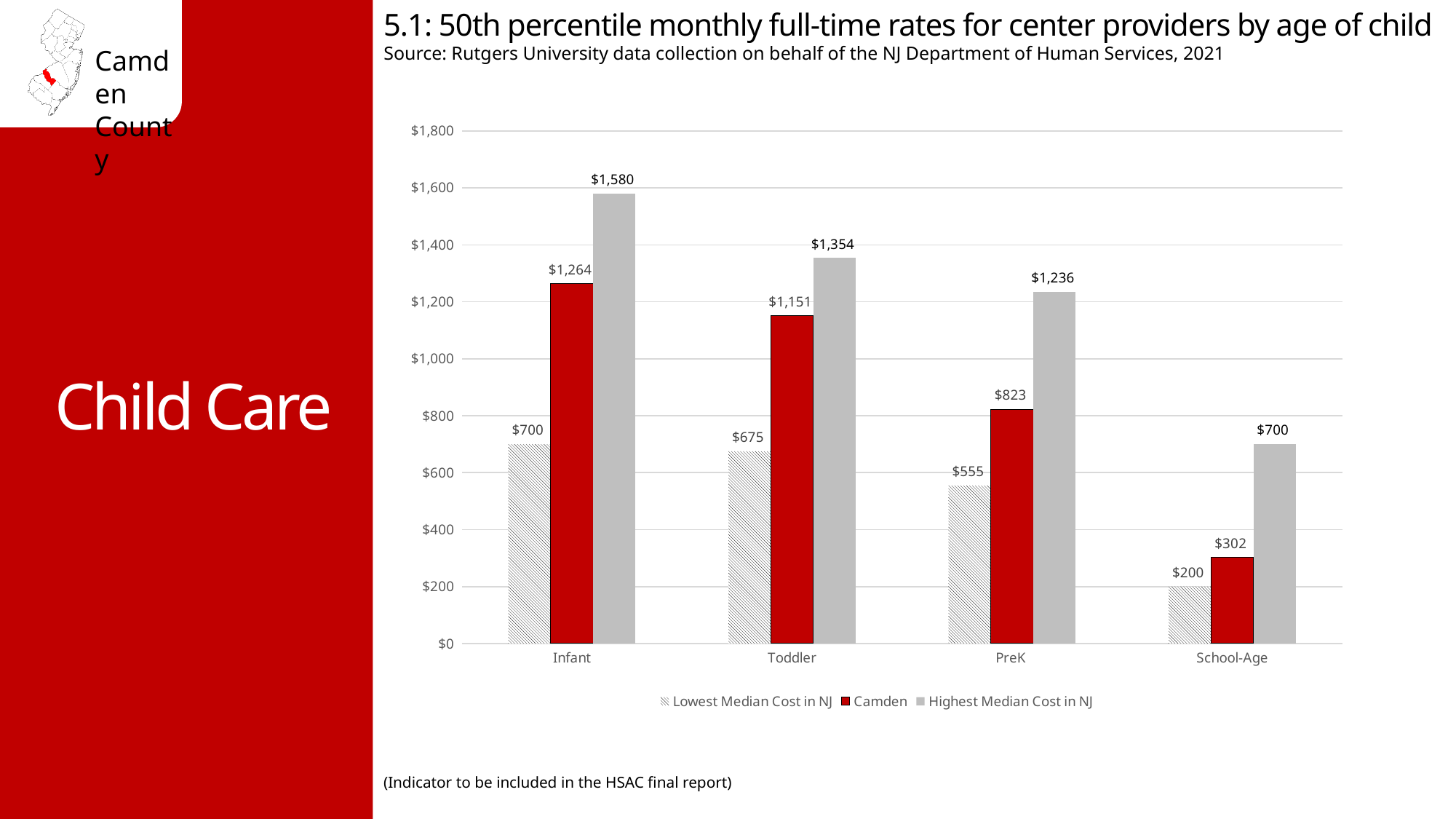
Do the Camden values rise or fall from Infant to School-Age? Fall Which age group has the lowest Highest Median Cost in NJ? School-Age What is the difference between the Highest Median Cost in NJ and the Camden value for Infant? $316 How many age groups are shown on the x axis? 4 What is the Lowest Median Cost in NJ for PreK? $555 What kind of chart is shown? Bar chart Which is larger: the Camden value for PreK or the Lowest Median Cost in NJ for Infant? Camden value for PreK What is the Camden value for School-Age? $302 What is the Camden value for Infant? $1,264 What is the Highest Median Cost in NJ for Toddler? $1,354 How many series does the legend list? 3 Which age group has the highest Camden value? Infant